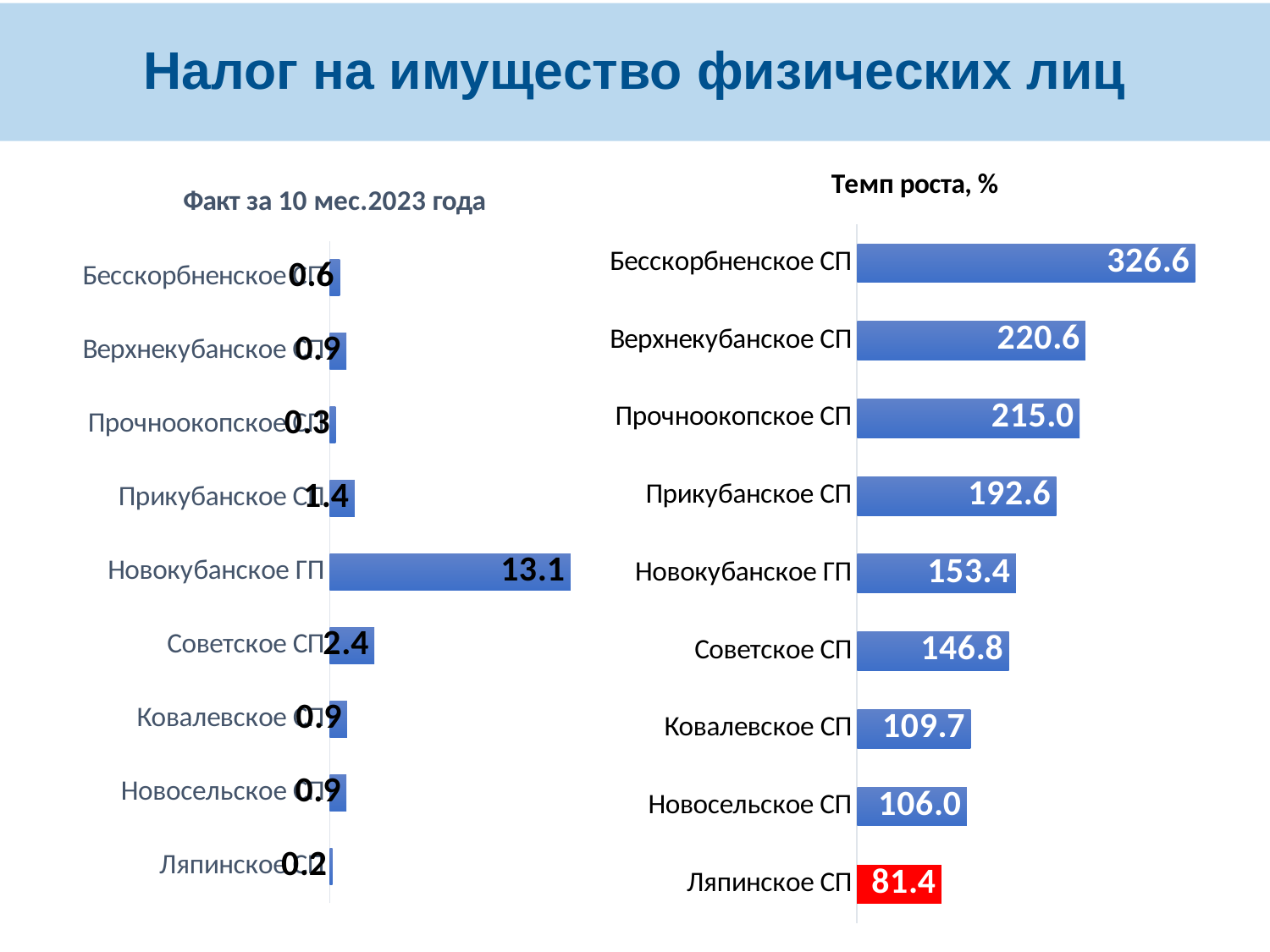
In the chart 'Факт за 10 мес.2023 года', which is larger: Советское СП or Прикубанское СП? Советское СП In the chart 'Факт за 10 мес.2023 года', which category has the highest value? Новокубанское ГП In the chart 'Темп роста, %', which bar is coloured red instead of blue? Ляпинское СП In the chart 'Факт за 10 мес.2023 года', what is the difference between Новокубанское ГП and Советское СП? 10.7 In the chart 'Темп роста, %', what is the value for Бесскорбненское СП? 326.6 How many categories are shown in the chart 'Темп роста, %'? 9 In the chart 'Факт за 10 мес.2023 года', what is the value for Новокубанское ГП? 13.1 What kind of chart is 'Факт за 10 мес.2023 года'? Bar chart In the chart 'Факт за 10 мес.2023 года', what is the value for Ляпинское СП? 0.2 In the chart 'Темп роста, %', what is the difference between Верхнекубанское СП and Прочноокопское СП? 5.6 In the chart 'Темп роста, %', which category has the lowest value? Ляпинское СП In the chart 'Темп роста, %', what is the value for Ковалевское СП? 109.7